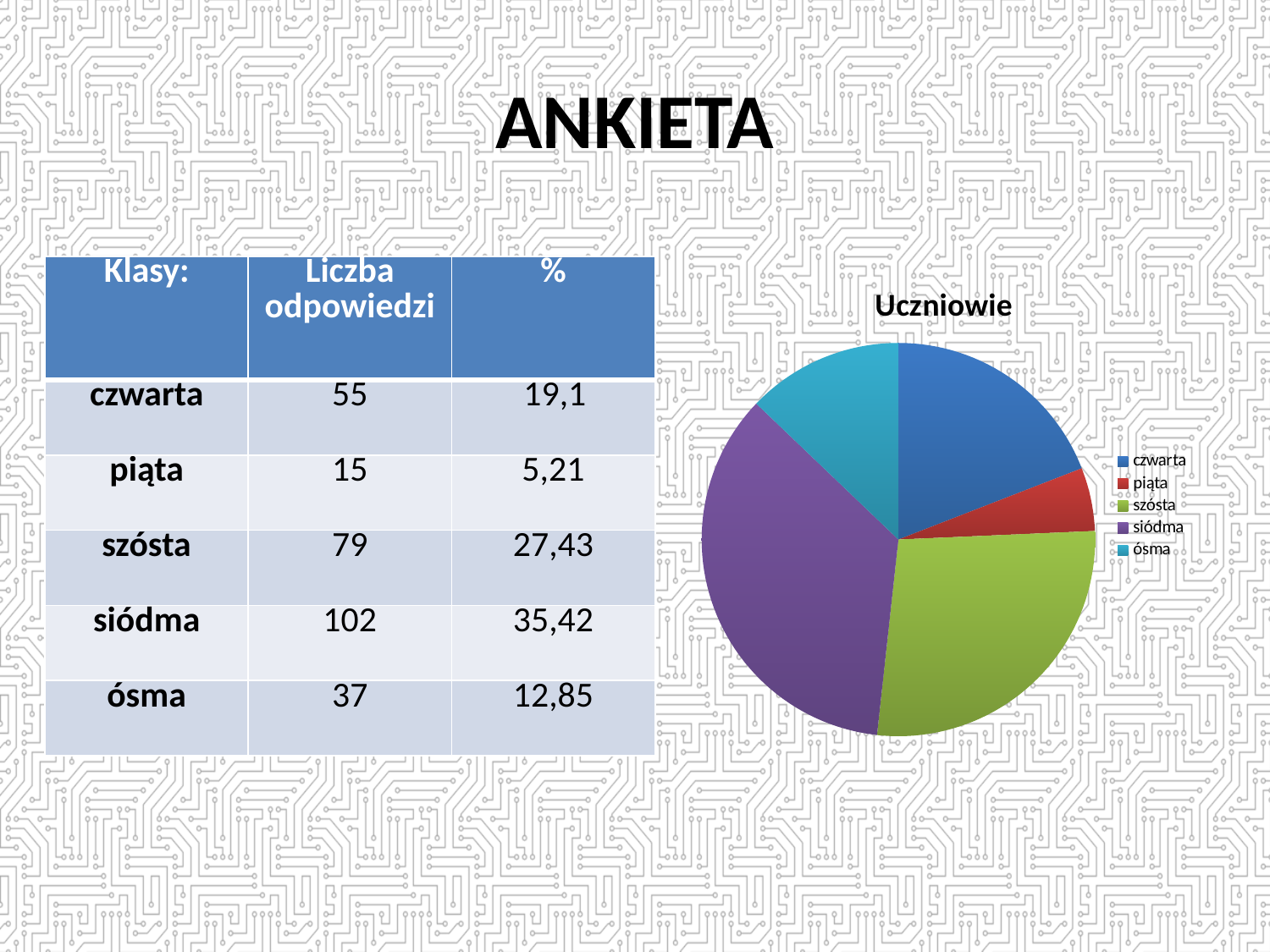
How many slices does the pie chart have? 5 According to the table on the slide, how many responses (Liczba odpowiedzi) does the szósta slice represent? 79 What is the title of the pie chart? Uczniowie According to the table on the slide, what share of the pie does piąta represent? 5,21 What colour is the siódma slice in the pie chart? purple Which slice is larger in the pie chart, czwarta or ósma? czwarta Which category has the largest slice in the pie chart? siódma Which slice is larger in the pie chart, szósta or czwarta? szósta What kind of chart is shown on the slide? pie chart Which slice is larger in the pie chart, siódma or szósta? siódma According to the table on the slide, what share of the pie does siódma represent? 35,42 Which category has the smallest slice in the pie chart? piąta